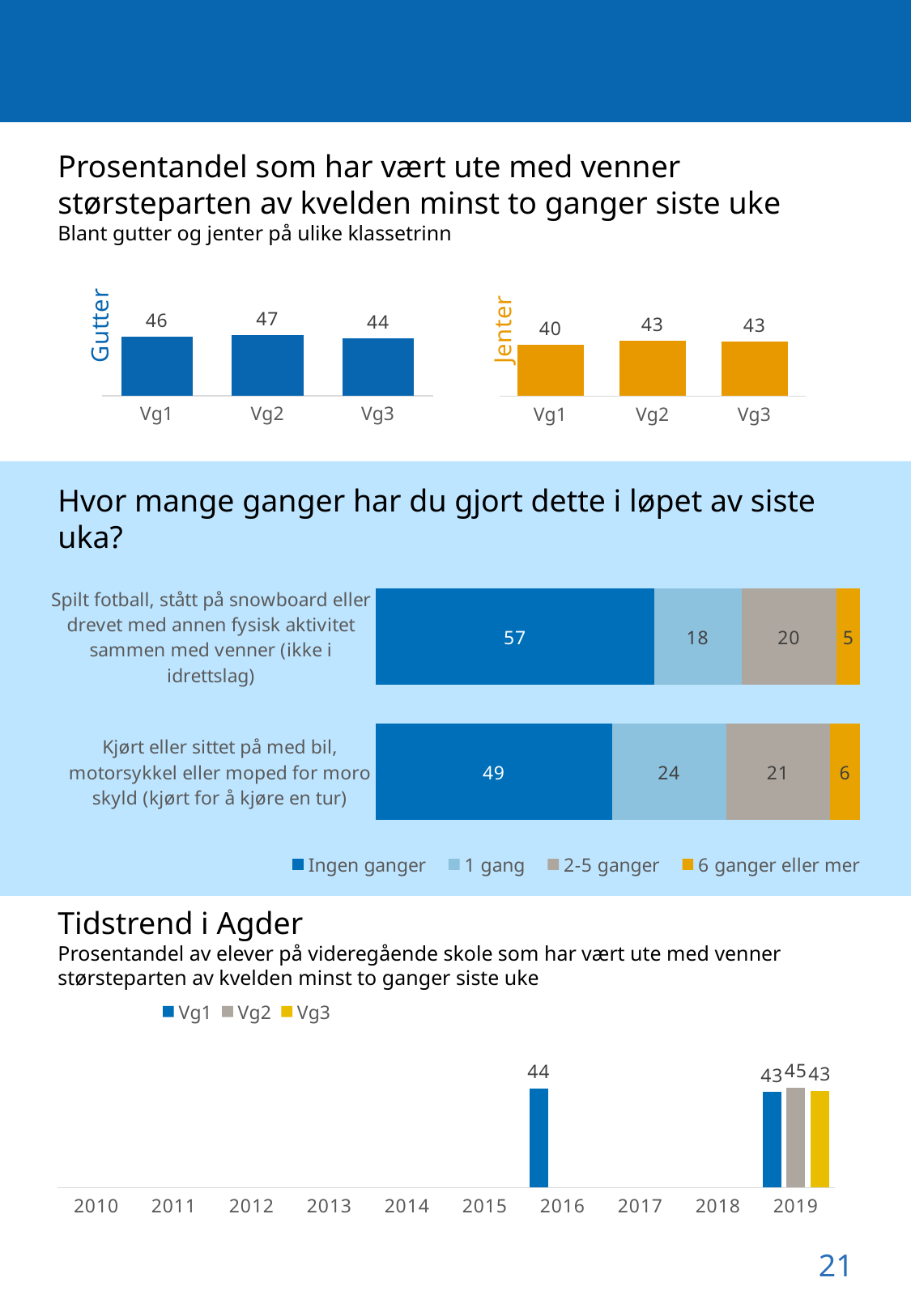
In the 'Tidstrend i Agder' chart, what is the Vg1 value for 2016? 44 In the top-right 'Jenter' chart, what is the value for Vg1? 40 What is the difference between the Vg1 value in the 'Gutter' chart and the Vg1 value in the 'Jenter' chart? 6 In the top-left 'Gutter' chart, what is the value for Vg2? 47 In the stacked bar chart 'Hvor mange ganger har du gjort dette i løpet av siste uka?', what is the total of the bar for 'Spilt fotball, stått på snowboard eller drevet med annen fysisk aktivitet sammen med venner'? 100 In the 'Tidstrend i Agder' chart, what is the Vg2 value for 2019? 45 What kind of chart is the 'Tidstrend i Agder' chart? Bar chart In the stacked bar chart 'Hvor mange ganger har du gjort dette i løpet av siste uka?', what is the '1 gang' value for 'Spilt fotball, stått på snowboard eller drevet med annen fysisk aktivitet sammen med venner'? 18 How many series does the legend of the stacked bar chart 'Hvor mange ganger har du gjort dette i løpet av siste uka?' list? 4 In the stacked bar chart 'Hvor mange ganger har du gjort dette i løpet av siste uka?', what is the 'Ingen ganger' value for 'Kjørt eller sittet på med bil, motorsykkel eller moped for moro skyld'? 49 In the top-right 'Jenter' chart, which category has the lowest value? Vg1 In the top-left 'Gutter' chart, which category has the lowest value? Vg3